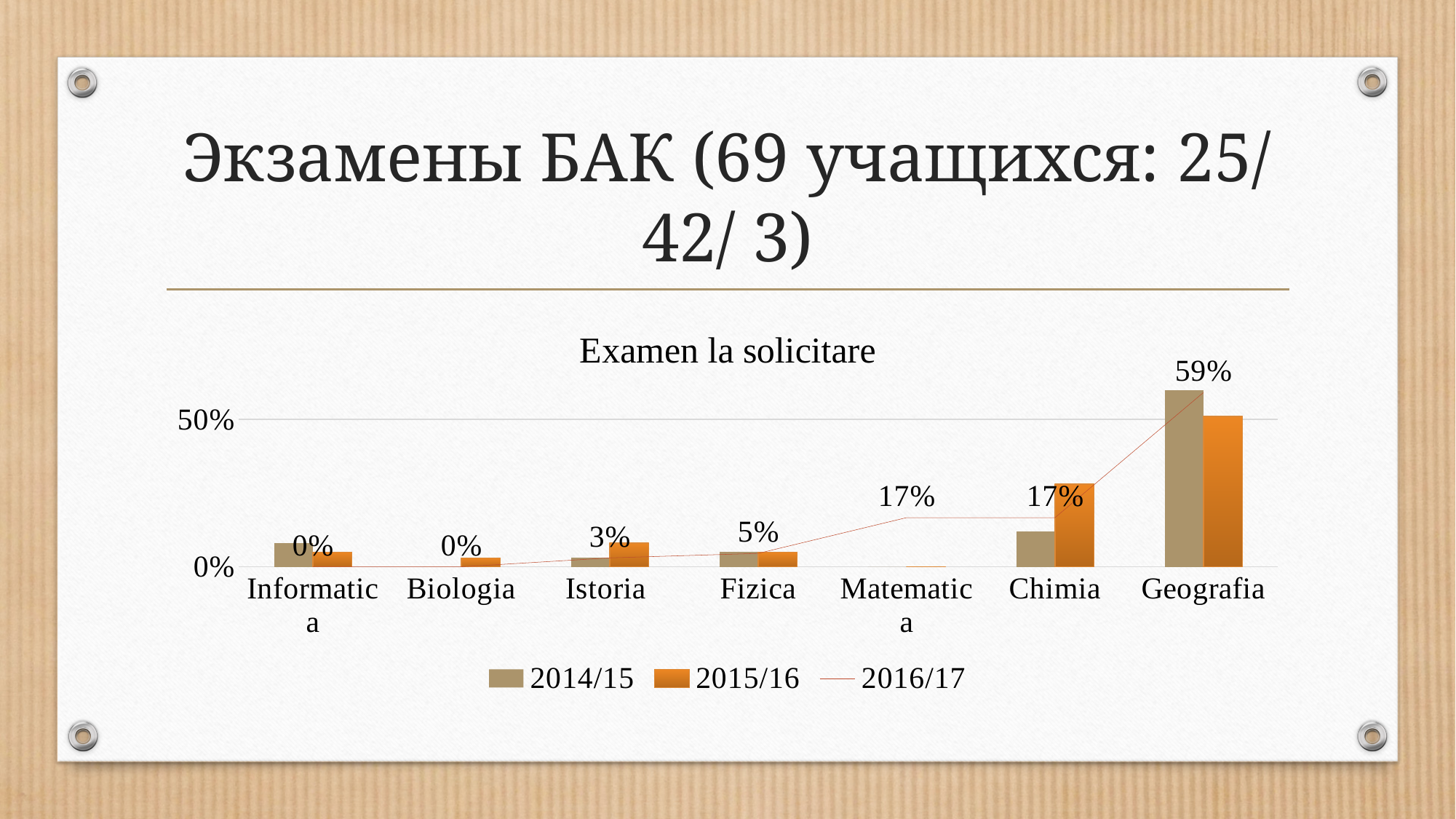
How many subjects are shown on the x axis? 7 What is the difference between the 2016/17 values for Geografia and Chimia? 42% What is the 2016/17 value for Istoria? 3% Is the 2014/15 value for Geografia greater or less than 50%? greater How many series does the legend list? 3 For Chimia, which series has the larger bar: 2014/15 or 2015/16? 2015/16 What is the 2016/17 value for Fizica? 5% What is the 2016/17 value for Geografia? 59% What is the 2016/17 value for Matematica? 17% Is the 2015/16 value for Chimia greater or less than 50%? less Which subject has the highest 2016/17 value? Geografia What is the title of the chart? Examen la solicitare